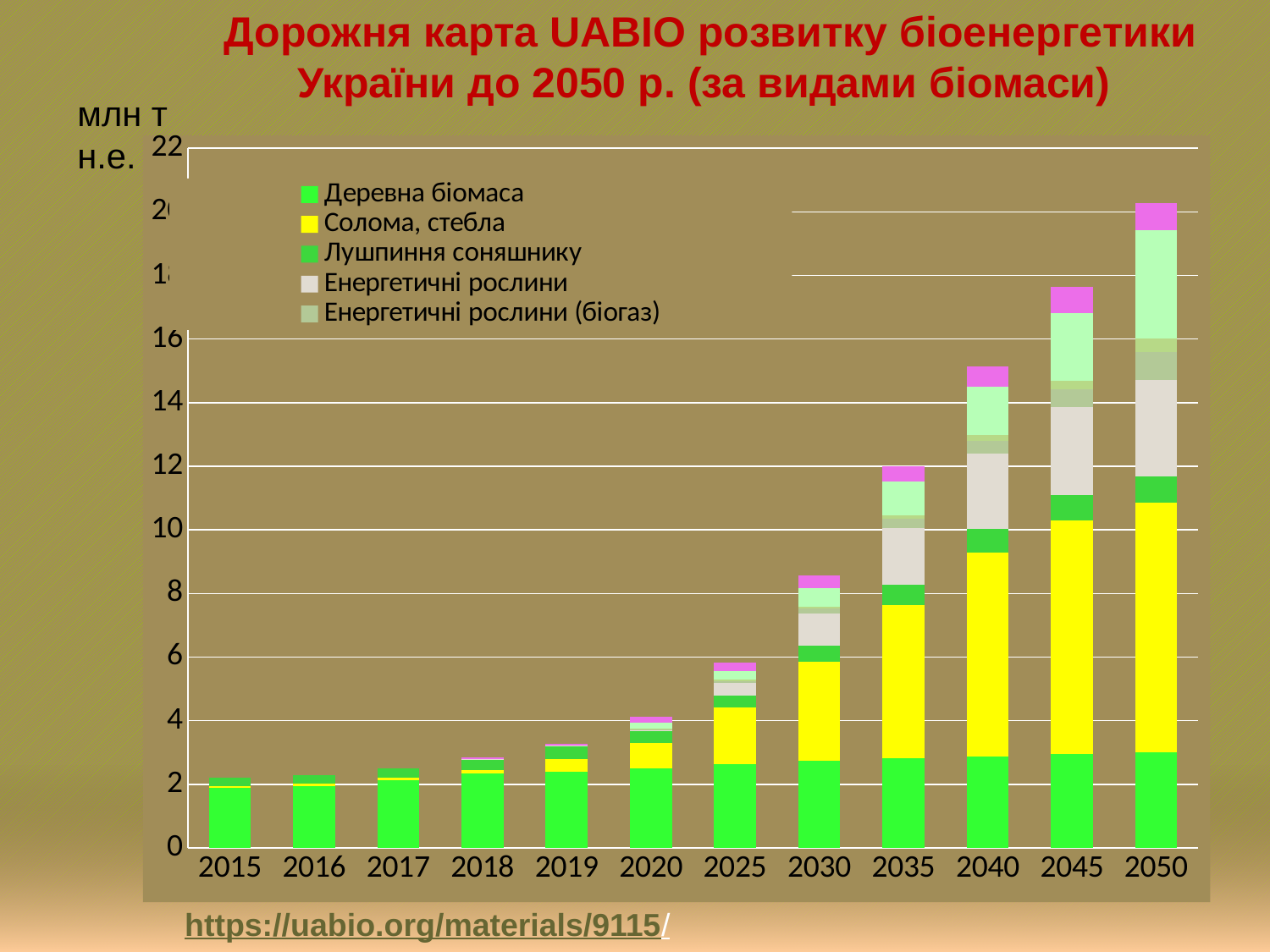
What kind of chart is shown on the slide? stacked bar chart Is the total for 2045 greater or less than 18? less Which year has the lowest total bar? 2015 Is the total for 2050 greater or less than 20? greater Is the total for 2040 greater or less than 14? greater Which series is shown at the bottom of each stacked bar? Деревна біомаса Which total is larger, 2030 or 2040? 2040 How many years (categories) are shown on the x axis? 12 Do the total bar heights rise or fall from 2015 to 2050? rise Which year has the highest total bar? 2050 How many series does the legend list? 5